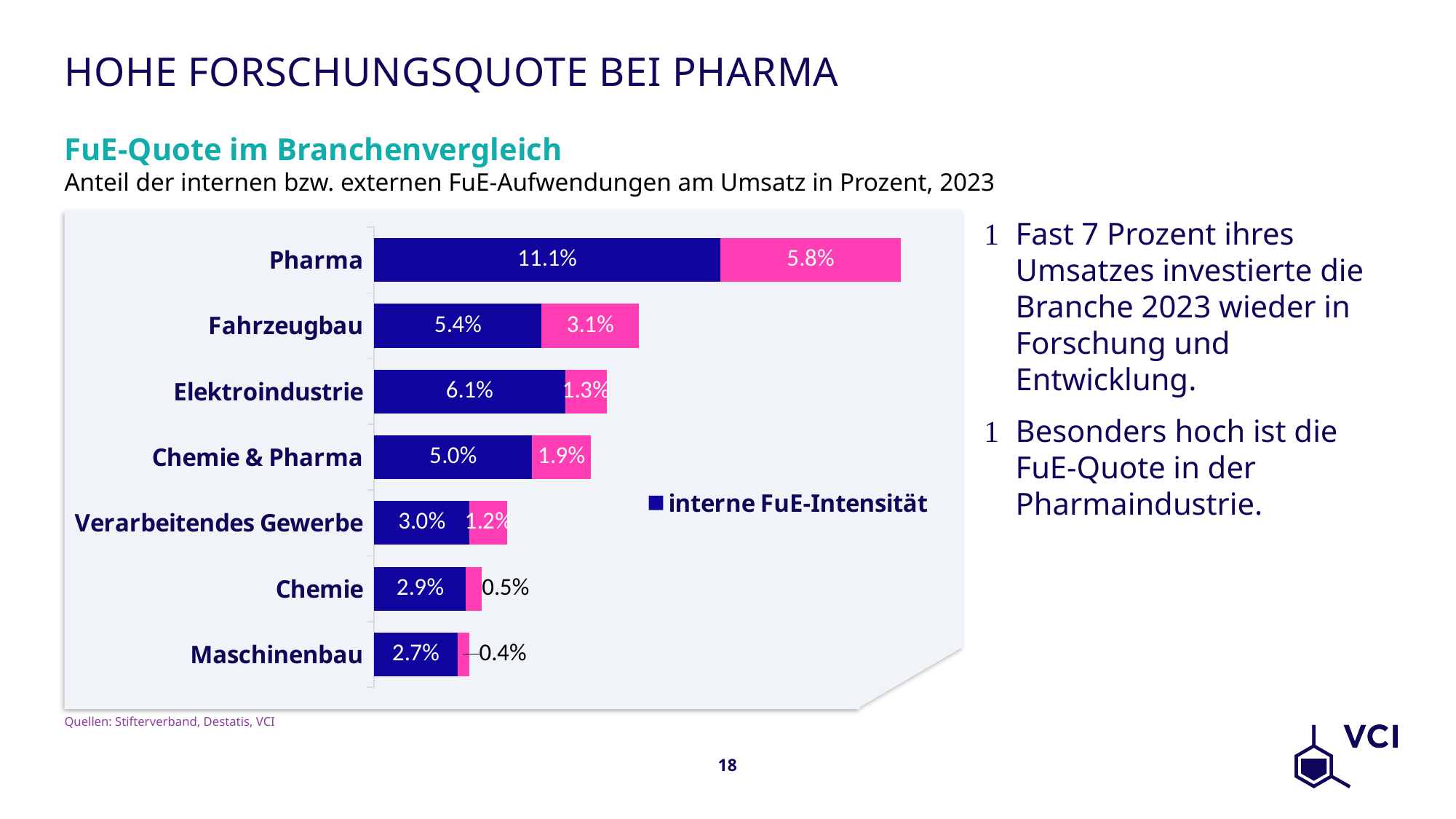
What is the title of the chart? FuE-Quote im Branchenvergleich What is the interne FuE-Intensität value for Pharma? 11.1% How many categories (industries) are shown in the chart? 7 What is the difference between the interne FuE-Intensität of Pharma and Fahrzeugbau? 5.7% Which has a larger interne FuE-Intensität, Elektroindustrie or Chemie & Pharma? Elektroindustrie What is the total of the stacked bar for Pharma? 16.9% What is the interne FuE-Intensität value for Elektroindustrie? 6.1% What is the total of the stacked bar for Chemie & Pharma? 6.9% Which category has the lowest interne FuE-Intensität? Maschinenbau What is the pink (second) segment value for Fahrzeugbau? 3.1% What kind of chart is shown on the slide? Stacked horizontal bar chart Which category has the highest interne FuE-Intensität? Pharma